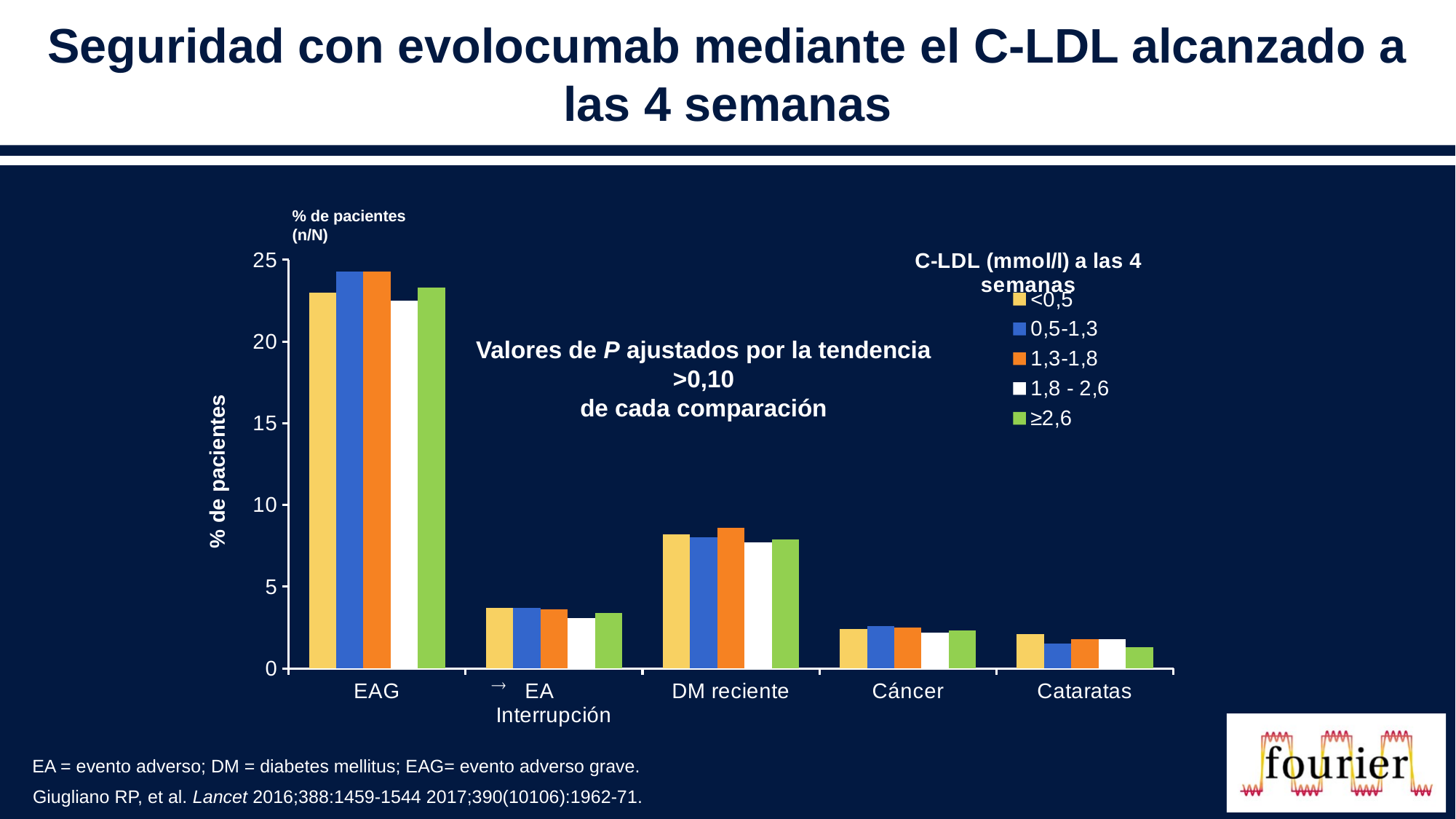
What kind of chart is shown on the slide? bar chart Is the value for the 0,5-1,3 series in the DM reciente category greater or less than 5? greater How many series does the chart legend list? 5 Which is larger: the 0,5-1,3 value for Cáncer or the 0,5-1,3 value for Cataratas? Cáncer Which category has the lowest values in the chart? Cataratas Is the value for the 1,3-1,8 series in the DM reciente category greater or less than 10? less Which category has the highest values in the chart? EAG What is the title of the chart's legend? C-LDL (mmol/l) a las 4 semanas Is the value for the <0,5 series in the EAG category greater or less than 20? greater How many categories are shown on the x axis of the chart? 5